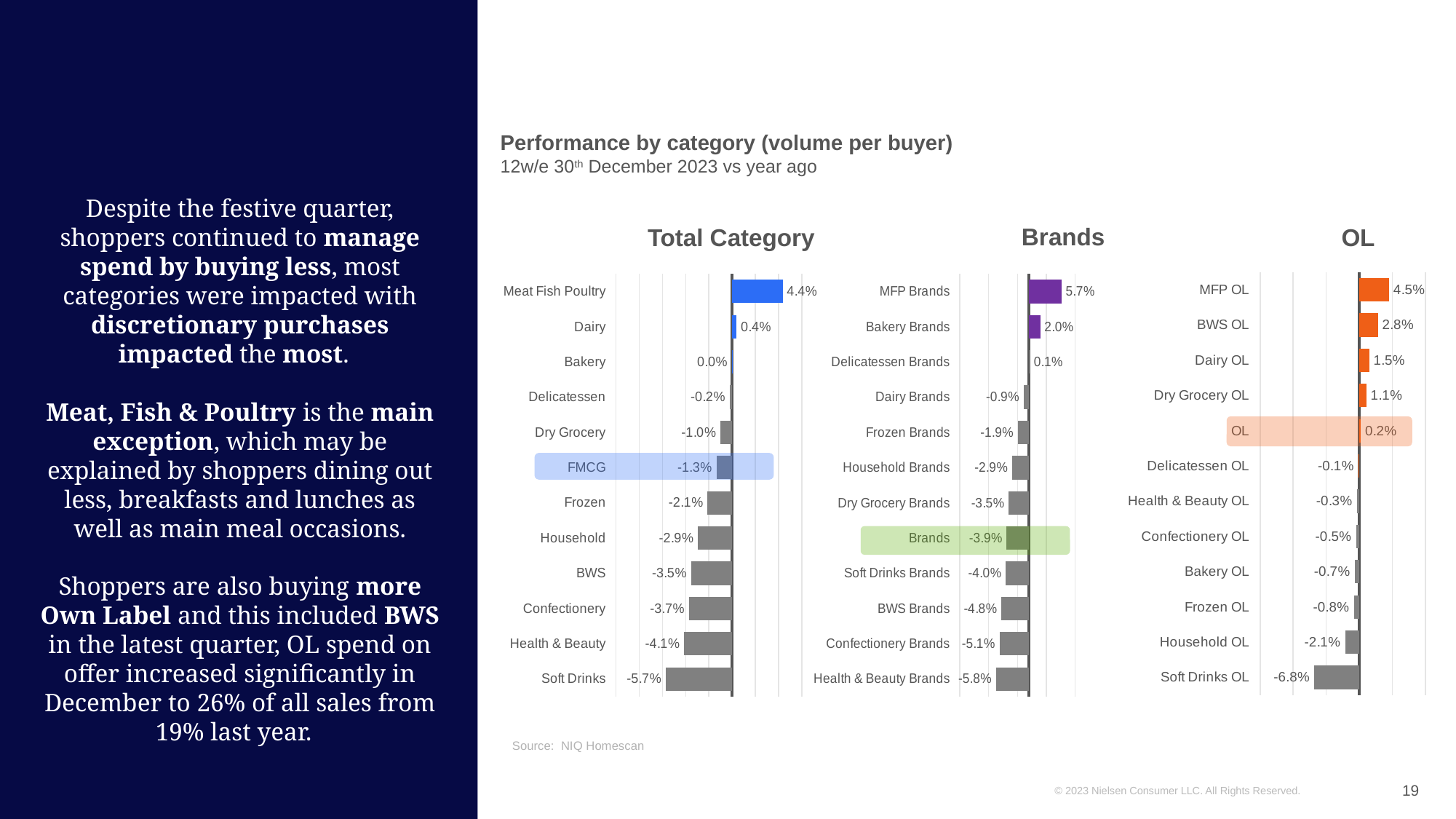
In the Total Category chart, what is the value for FMCG? -1.3% In the Brands chart, which category has the lowest value? Health & Beauty Brands In the Brands chart, what is the value for MFP Brands? 5.7% In the Total Category chart, which category has the lowest value? Soft Drinks In the Brands chart, what is the difference between Bakery Brands and Confectionery Brands? 7.1 percentage points How many categories are shown in the Total Category chart? 12 In the OL chart, what is the value for Soft Drinks OL? -6.8% What kind of chart is the Brands chart? Bar chart In the OL chart, which category has the highest value? MFP OL In the OL chart, what is the value for BWS OL? 2.8% In the Total Category chart, what is the value for Meat Fish Poultry? 4.4% In the OL chart, which is larger, the value for Dairy OL or Dry Grocery OL? Dairy OL